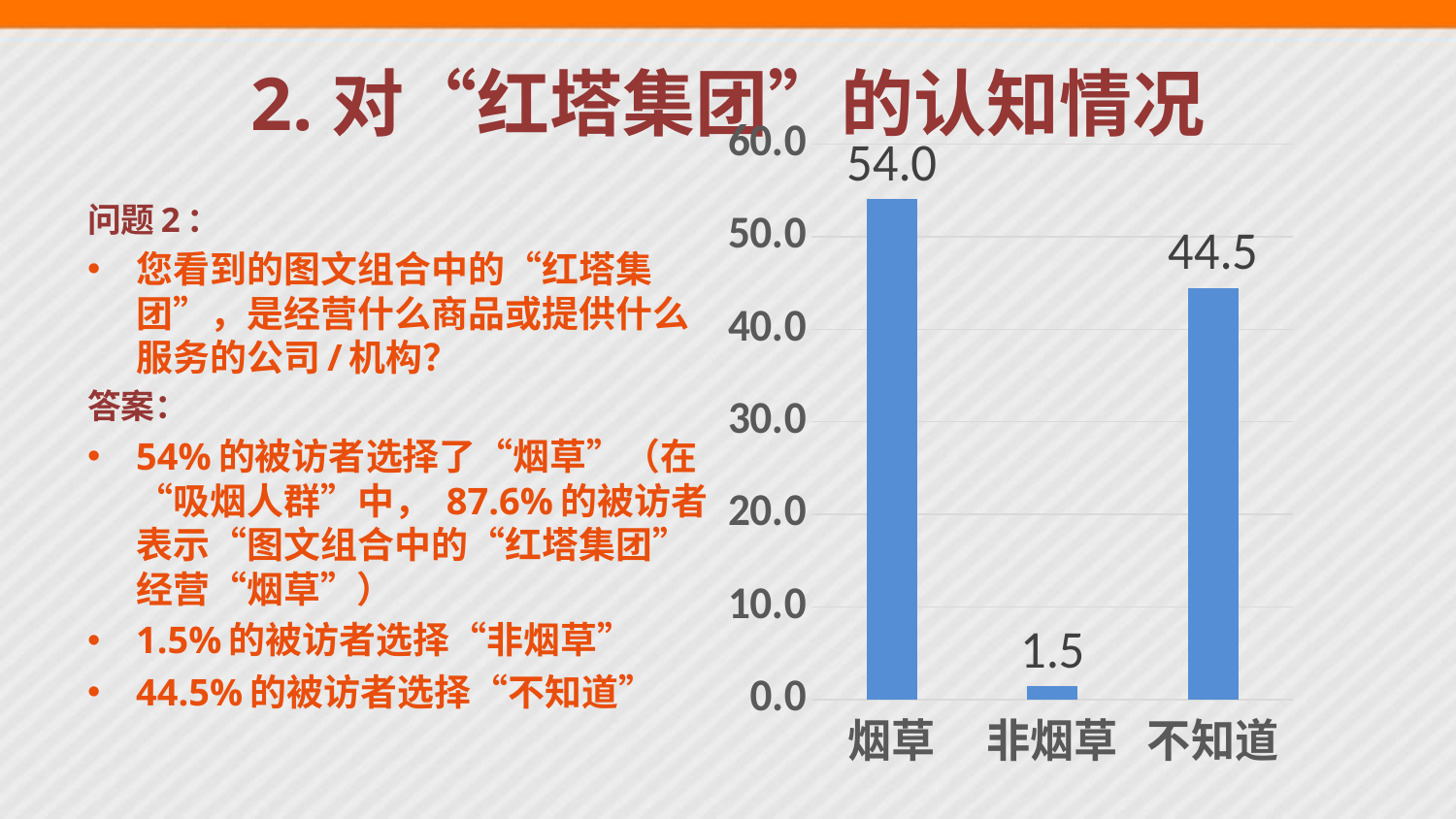
How many categories are shown on the x axis? 3 What is the value for 烟草? 54.0 What is the difference between the values for 烟草 and 不知道? 9.5 Is the value for 不知道 greater or less than 40.0? greater Which category has the highest value? 烟草 What kind of chart is shown on the slide? bar chart What is the value for 不知道? 44.5 Which is larger, the value for 烟草 or the value for 不知道? 烟草 What is the difference between the values for 不知道 and 非烟草? 43.0 What is the value for 非烟草? 1.5 Which category has the lowest value? 非烟草 What is the highest value shown on the y axis? 60.0